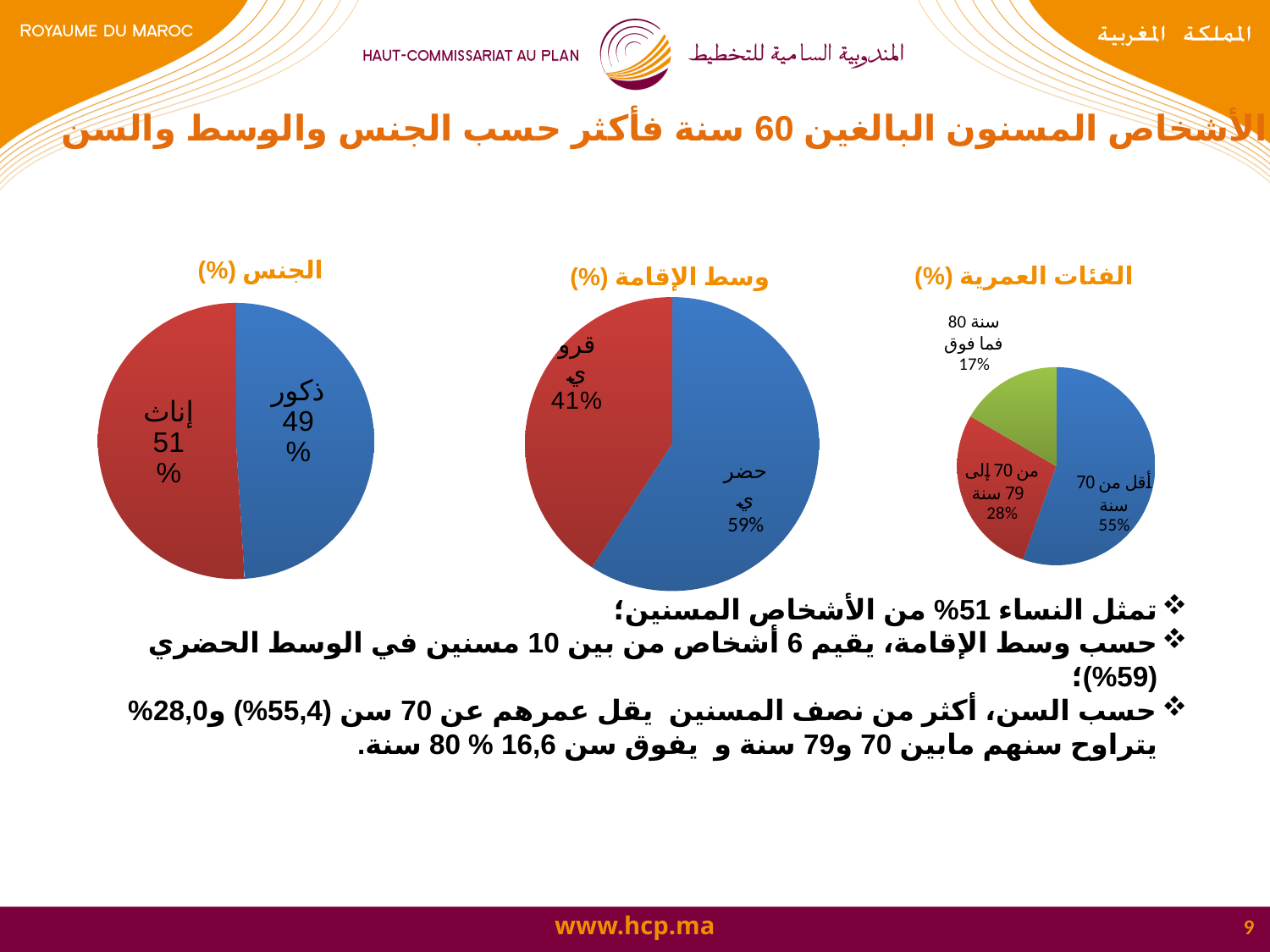
In the chart titled "وسط الإقامة (%)", what is the value for حضري? 59% In the chart titled "الفئات العمرية (%)", which category has the smallest share? 80 سنة فما فوق In the chart titled "الجنس (%)", what is the value for إناث? 51% What type of chart is the one titled "الجنس (%)"? Pie chart In the chart titled "وسط الإقامة (%)", what is the difference between حضري and قروي? 18% How many charts are shown on the slide? 3 In the chart titled "وسط الإقامة (%)", what is the value for قروي? 41% In the chart titled "الجنس (%)", what is the value for ذكور? 49% In the chart titled "الفئات العمرية (%)", what is the value for 80 سنة فما فوق? 17% In the chart titled "الفئات العمرية (%)", how many categories are shown? 3 In the chart titled "الفئات العمرية (%)", what is the value for أقل من 70 سنة? 55% In the chart titled "الفئات العمرية (%)", which category has the largest share? أقل من 70 سنة